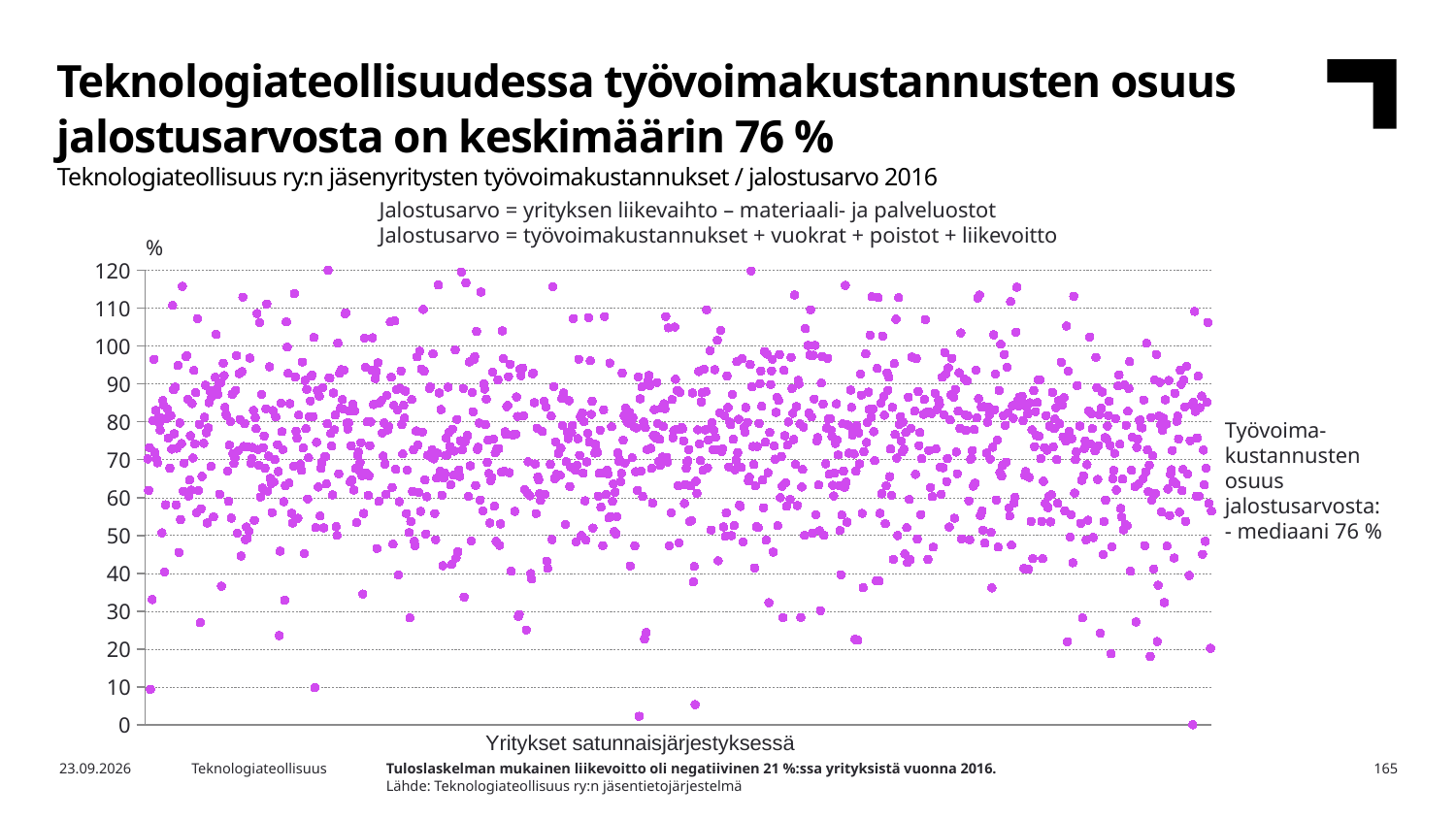
What is the label of the x axis of the chart? Yritykset satunnaisjärjestyksessä What kind of chart is shown on the slide? scatter chart What unit is shown at the top of the y axis of the chart? % According to the annotation on the right of the chart, what is the median share of labour costs in value added (mediaani)? 76 %